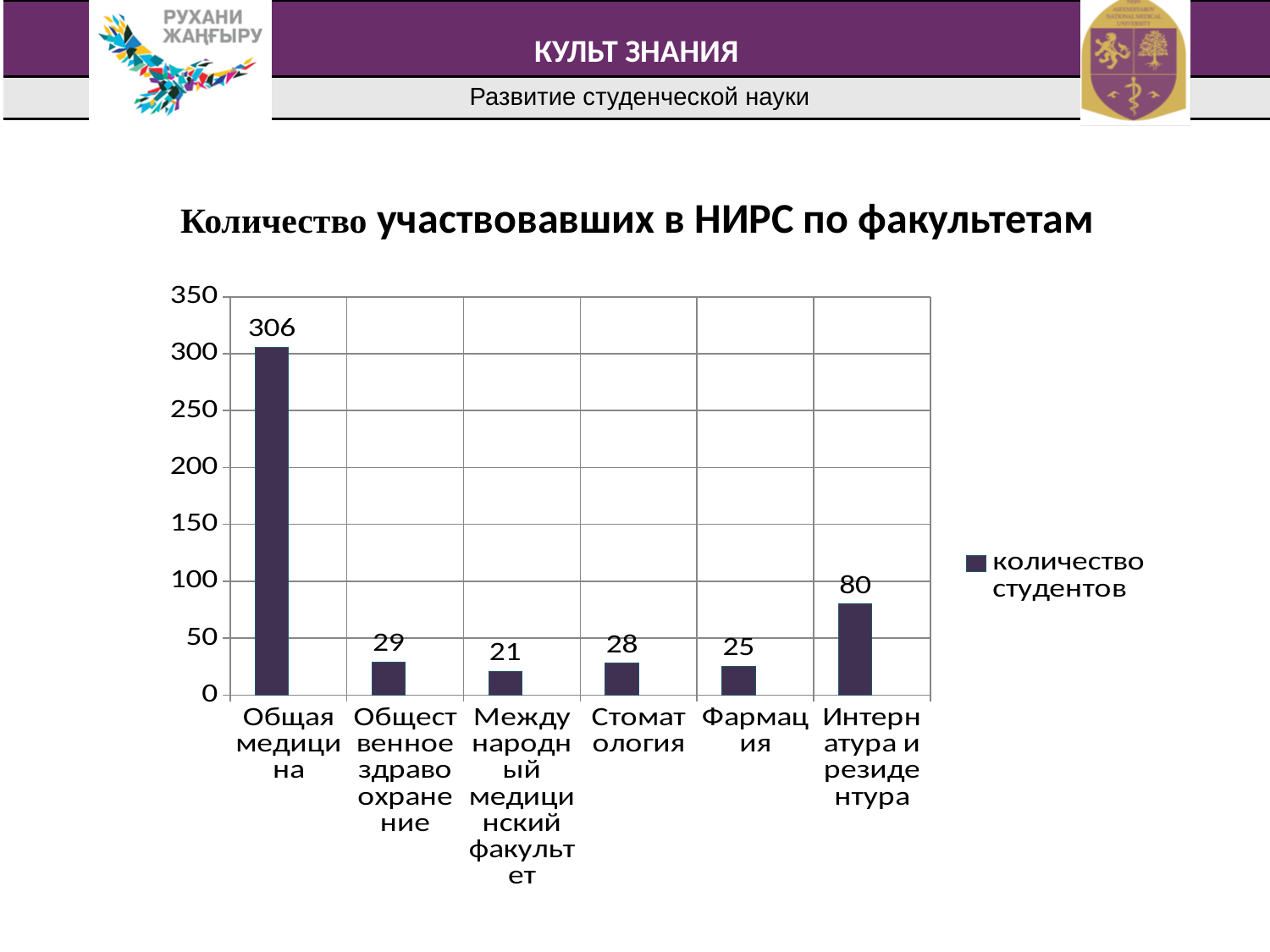
What kind of chart is shown on the slide? bar chart What is the value for Международный медицинский факультет? 21 Which is larger, the value for Стоматология or the value for Фармация? Стоматология Is the value for Интернатура и резидентура greater or less than 100? less Which faculty has the highest number of students? Общая медицина What is the legend entry of the chart? количество студентов What is the value for Интернатура и резидентура? 80 What is the value for Общая медицина? 306 What is the difference between the values for Общая медицина and Интернатура и резидентура? 226 What is the difference between the values for Общественное здравоохранение and Фармация? 4 How many faculties are shown on the chart? 6 Which faculty has the lowest number of students? Международный медицинский факультет